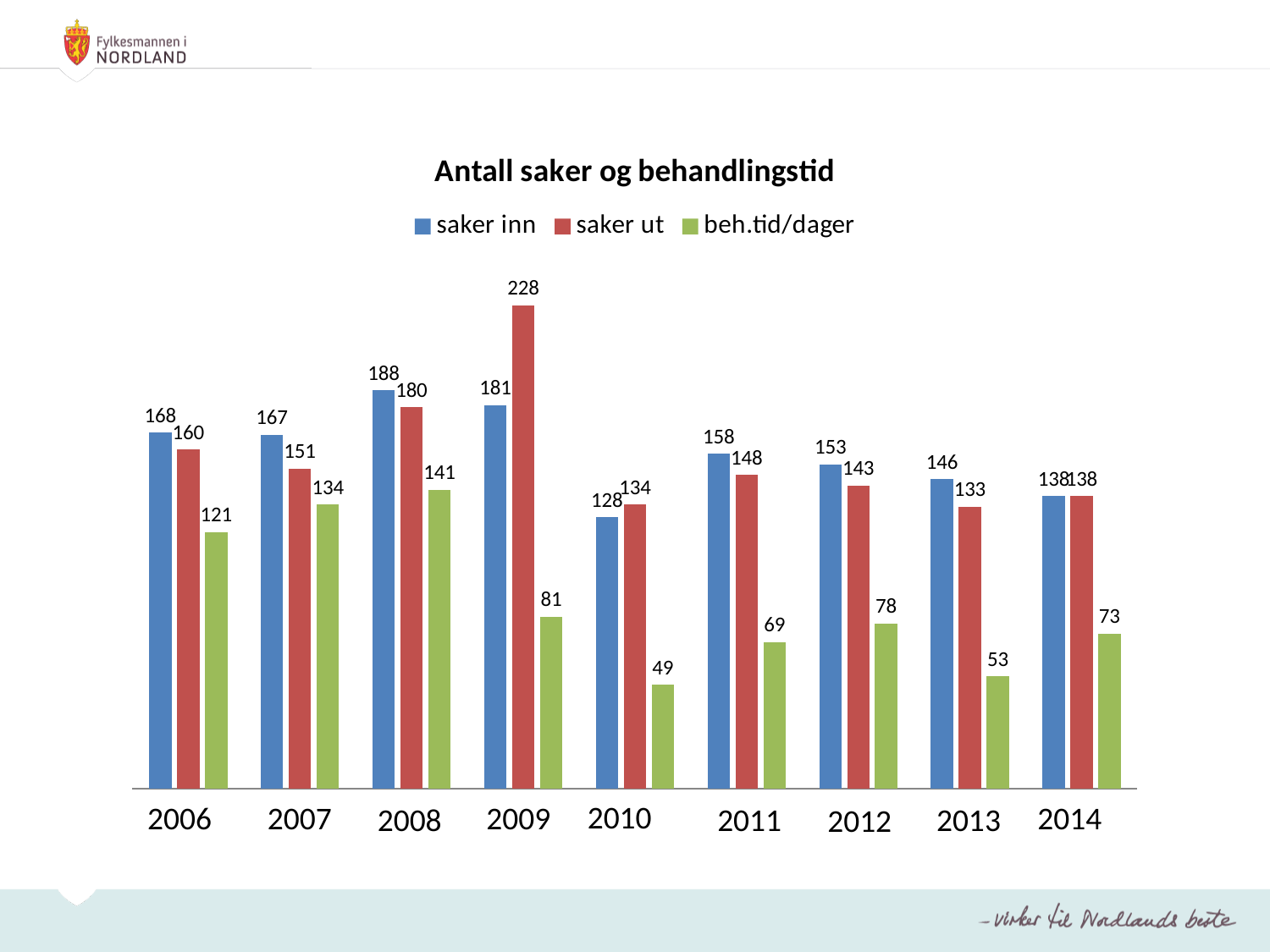
Which year has the highest value for saker ut? 2009 What is the value of saker ut for 2009? 228 Which year has the lowest value for beh.tid/dager? 2010 What kind of chart is shown on the slide? bar chart What is the value of beh.tid/dager for 2010? 49 How many series does the legend list? 3 Which is larger in 2011, saker inn or saker ut? saker inn How many years are shown on the x axis? 9 Which year has the lowest value for saker inn? 2010 What is the difference between saker ut and saker inn in 2009? 47 What is the value of saker inn for 2008? 188 What is the title of the chart? Antall saker og behandlingstid